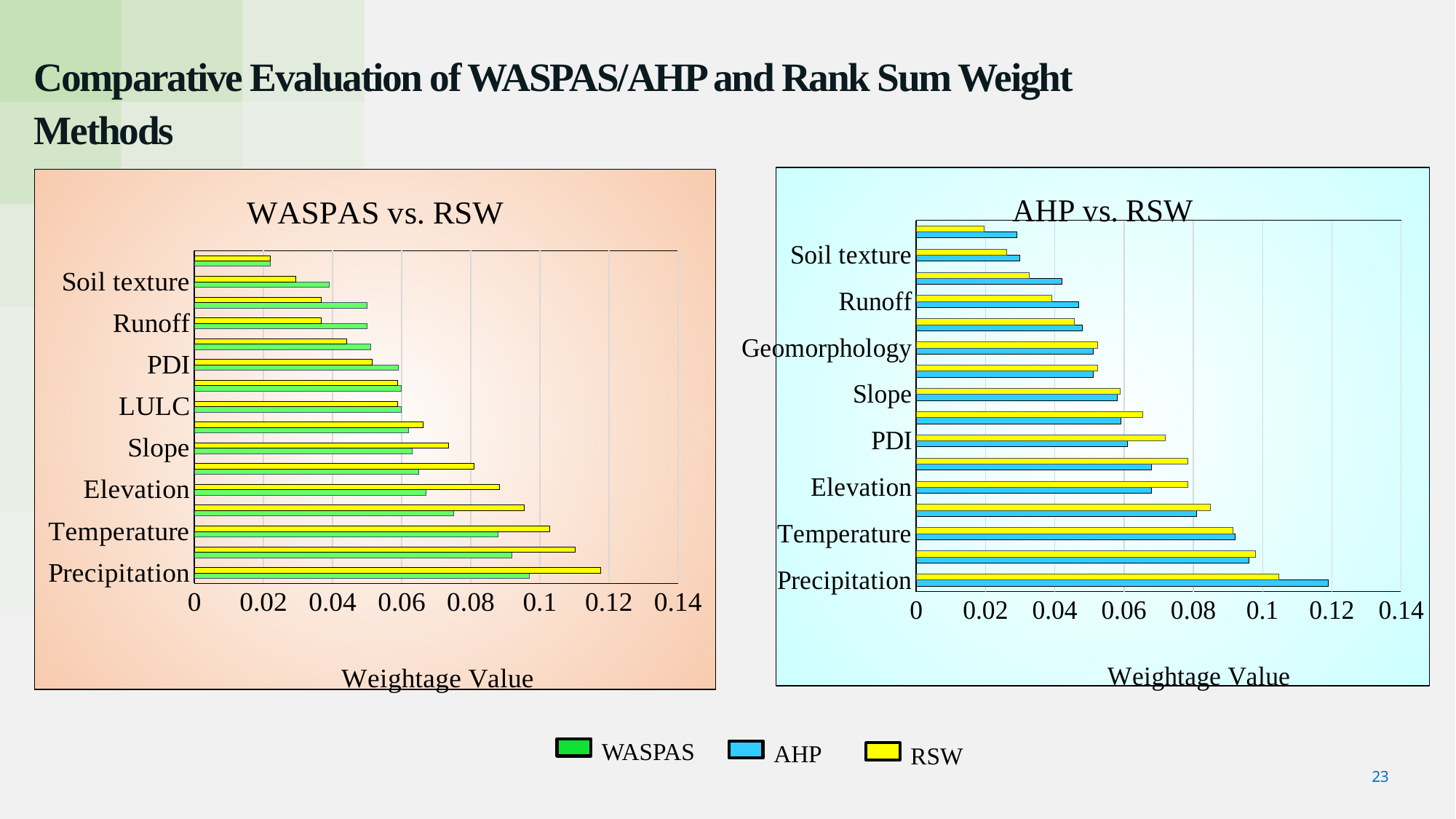
In the "AHP vs. RSW" chart, for Precipitation, which is larger: the AHP value or the RSW value? AHP In the "AHP vs. RSW" chart, is the AHP value for Soil texture greater or less than 0.04? less In the "AHP vs. RSW" chart, which labelled category has the lowest values? Soil texture In the "AHP vs. RSW" chart, is the AHP value for Precipitation greater or less than 0.1? greater What type of chart is the "WASPAS vs. RSW" chart? bar chart In the "WASPAS vs. RSW" chart, for Precipitation, which is larger: the WASPAS value or the RSW value? RSW In the "WASPAS vs. RSW" chart, is the WASPAS value for Runoff greater or less than 0.06? less In the "WASPAS vs. RSW" chart, for Elevation, which is larger: the WASPAS value or the RSW value? RSW In the "WASPAS vs. RSW" chart, which labelled category has the highest values? Precipitation How many series does the legend at the bottom of the slide list? 3 What is the x-axis title of the "AHP vs. RSW" chart? Weightage Value